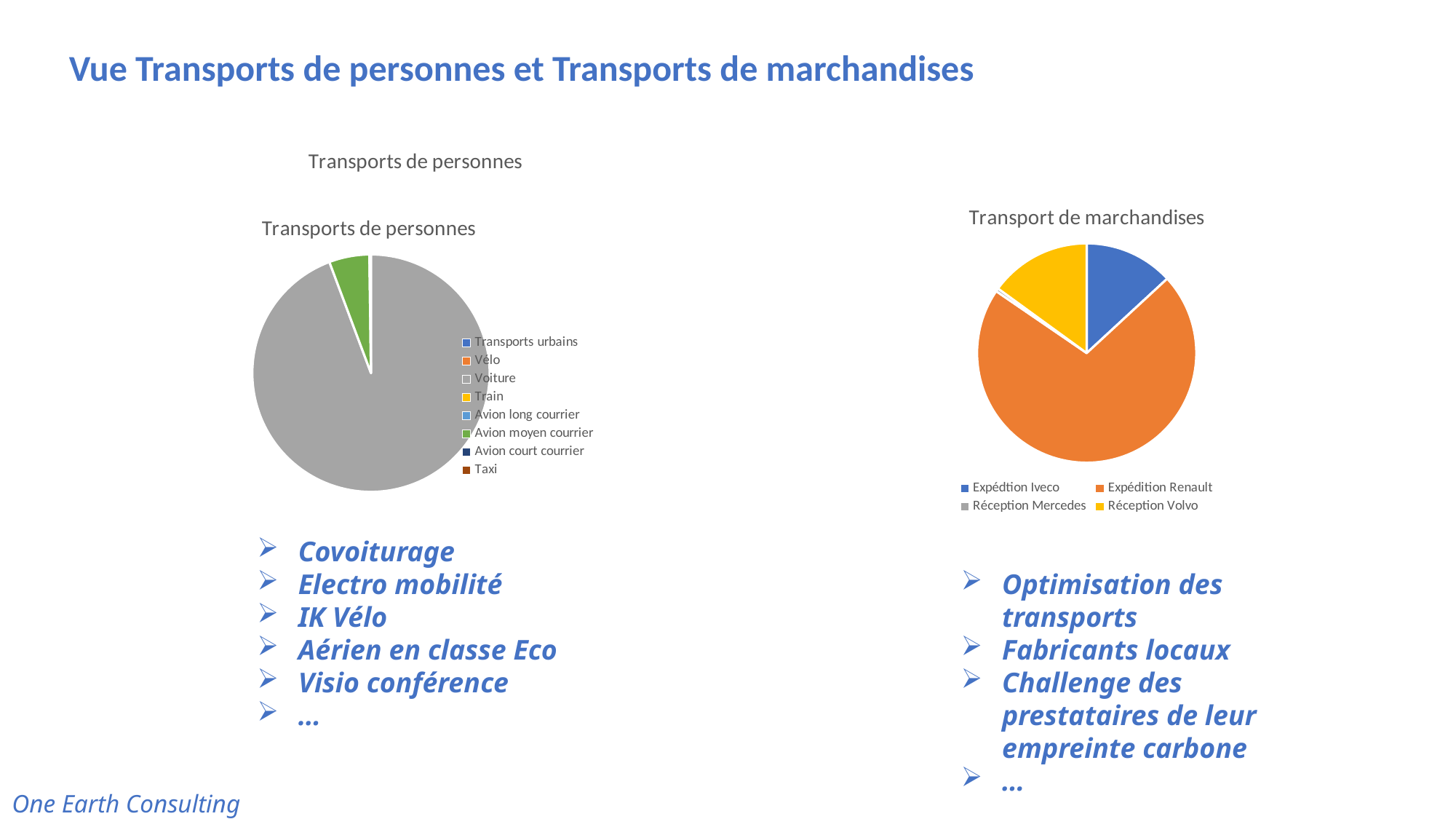
In the "Transport de marchandises" chart, how many entries does the legend list? 4 In the "Transport de marchandises" chart, which is larger: Expédition Renault or Réception Volvo? Expédition Renault In the "Transports de personnes" chart, which category has the largest slice? Voiture In the "Transport de marchandises" chart, what colour is the Réception Volvo slice? yellow In the "Transports de personnes" chart, which legend entry is shown in green? Avion moyen courrier What kind of chart is the "Transports de personnes" chart? pie chart In the "Transports de personnes" chart, how many entries does the legend list? 8 In the "Transport de marchandises" chart, which is larger: Expédition Renault or Expédtion Iveco? Expédition Renault In the "Transport de marchandises" chart, which category has the largest slice? Expédition Renault In the "Transports de personnes" chart, which is larger: Voiture or Avion moyen courrier? Voiture What kind of chart is the "Transport de marchandises" chart? pie chart